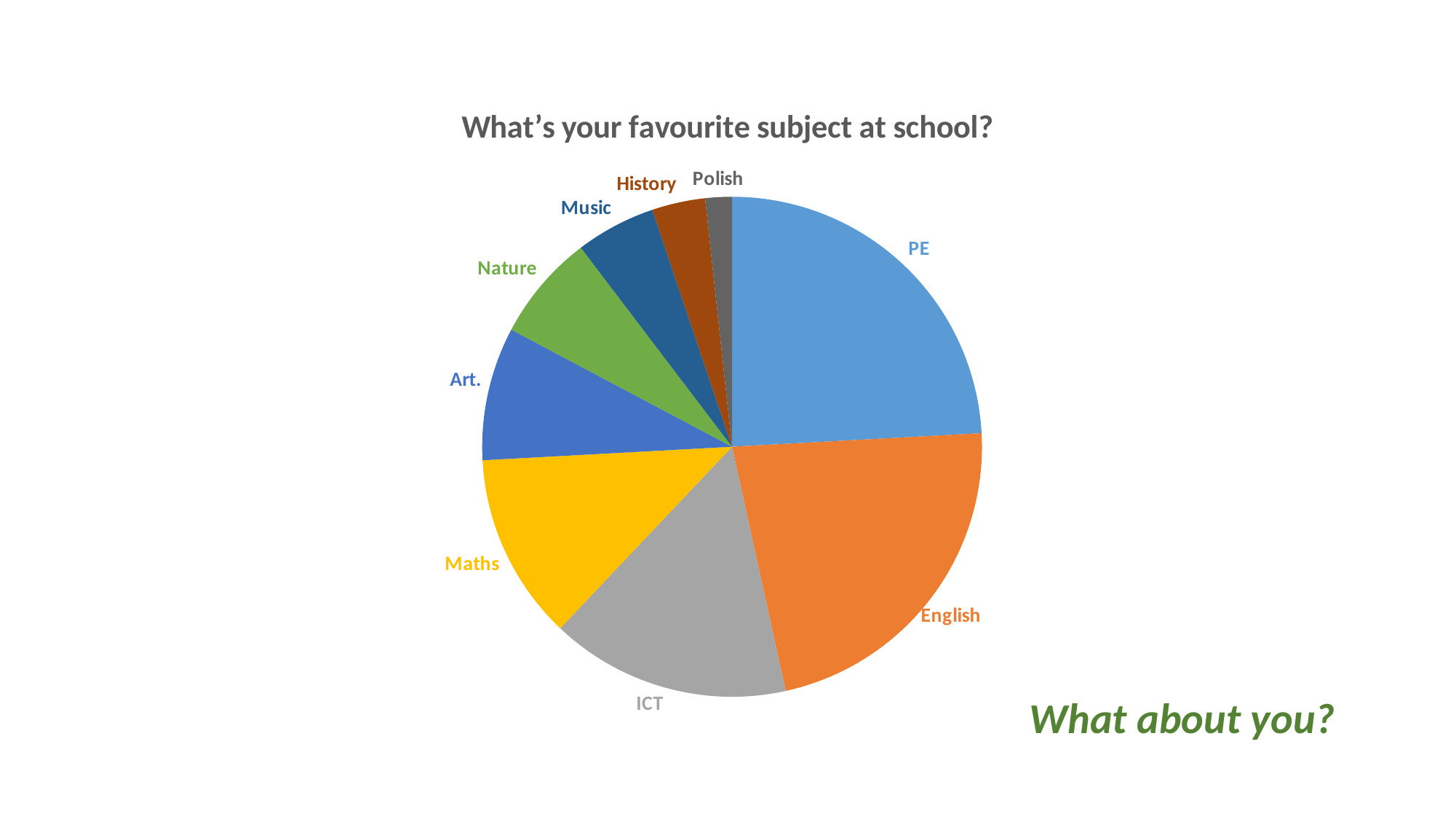
What colour is the English slice in the pie chart? orange How many subjects (slices) does the pie chart show? 9 Which slice is larger, Art. or Nature? Art. Which slice is larger, English or Maths? English What kind of chart is shown on the slide? pie chart Which slice is larger, History or Polish? History What is the title of the pie chart? What's your favourite subject at school? Which subject has the smallest slice in the pie chart? Polish